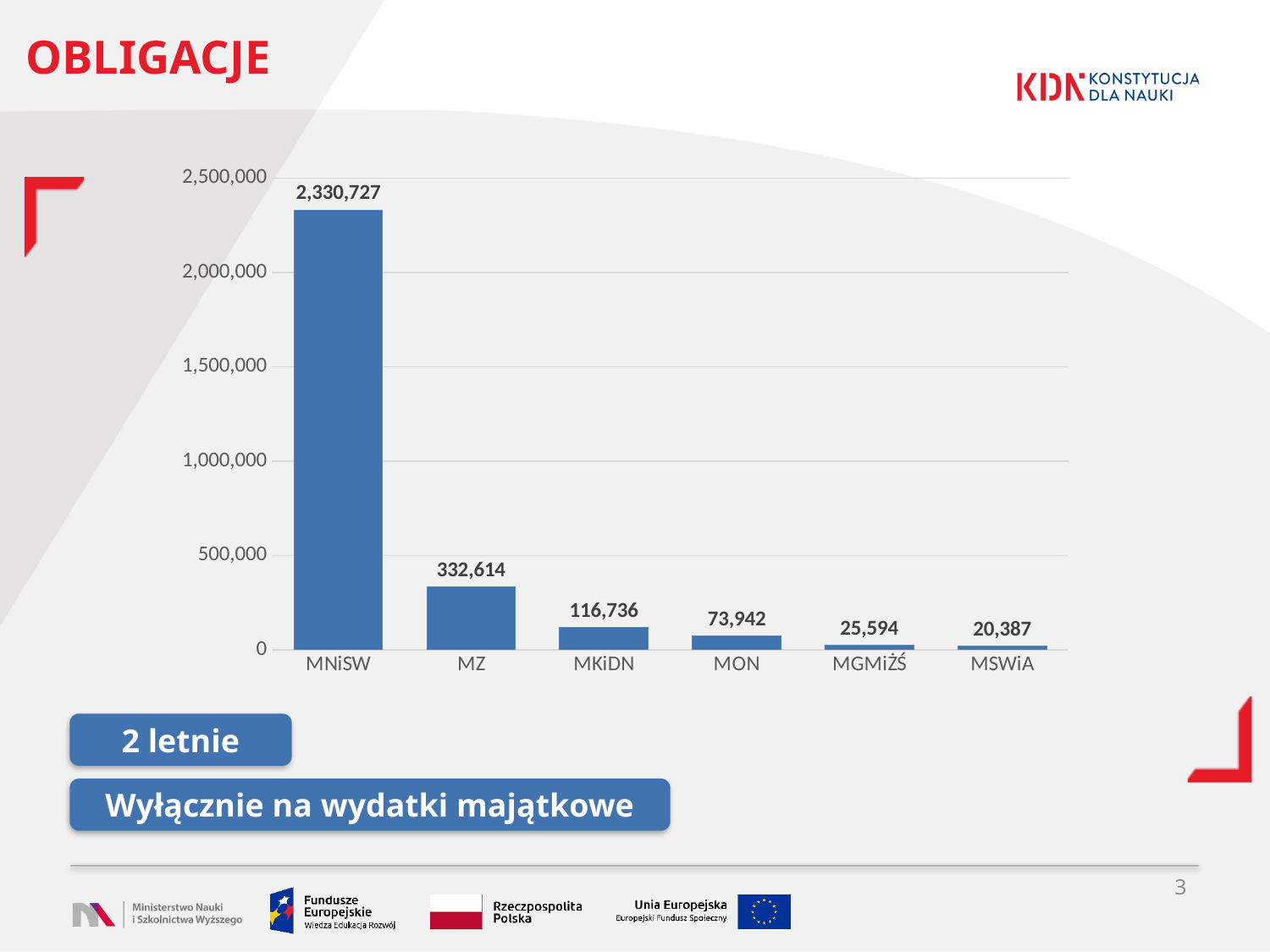
What is the value for MZ? 332,614 What is the value for MKiDN? 116,736 Which is larger, the value for MZ or the value for MKiDN? MZ What is the value for MON? 73,942 What is the difference between the values for MON and MGMiŻŚ? 48,348 What is the difference between the values for MNiSW and MZ? 1,998,113 Which category has the lowest value? MSWiA How many categories are shown on the x axis? 6 What is the value for MSWiA? 20,387 What is the value for MNiSW? 2,330,727 Is the value for MNiSW greater or less than 2,000,000? greater Which category has the highest value? MNiSW